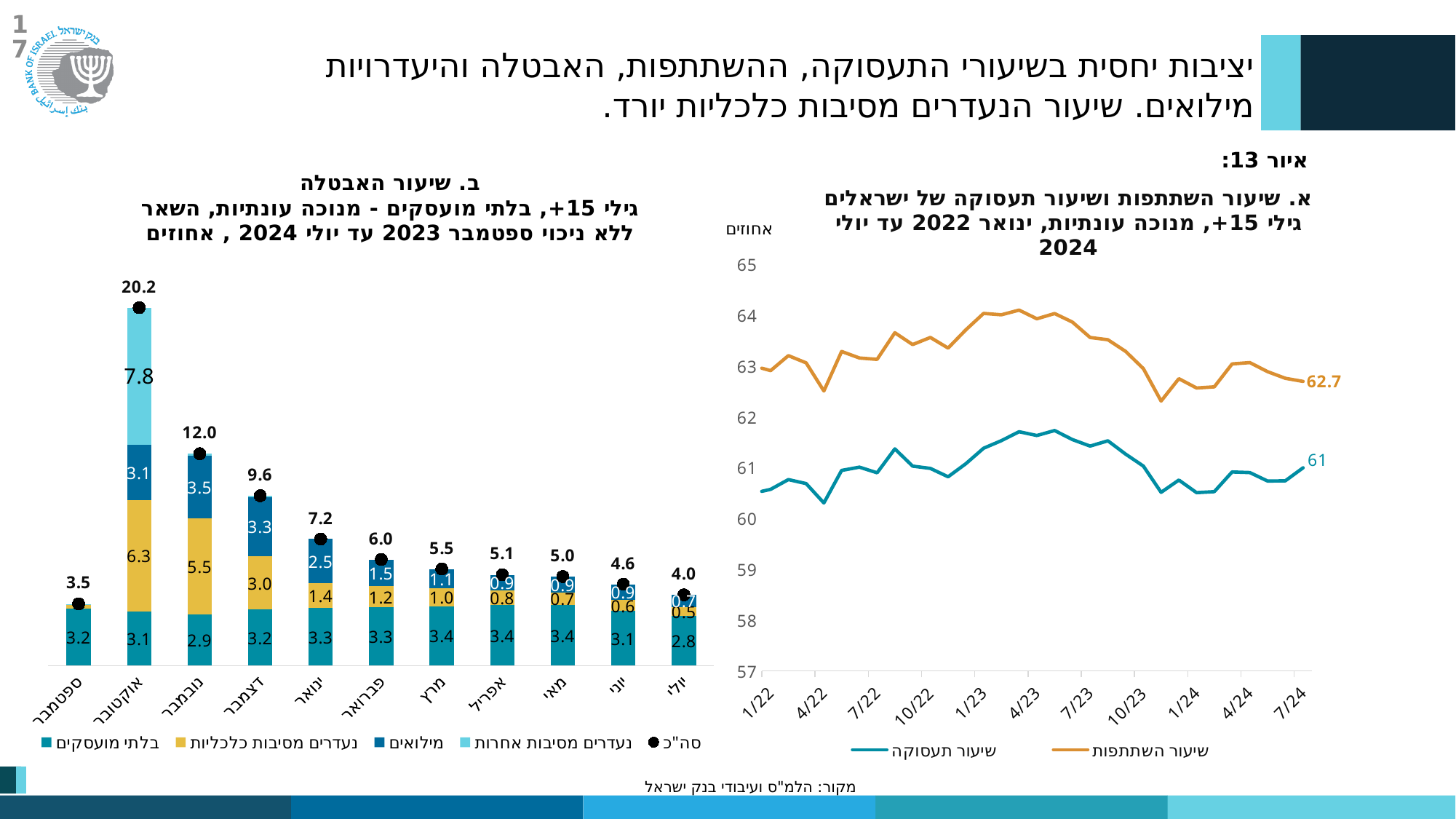
How many series does the legend of the right chart (א. שיעור השתתפות ושיעור תעסוקה) list? 2 In the right chart (א. שיעור השתתפות ושיעור תעסוקה), is the value of שיעור תעסוקה at 4/22 greater or less than 61? less In the left chart (ב. שיעור האבטלה), which month has the highest total? אוקטובר In the left chart (ב. שיעור האבטלה), what is the value of בלתי מועסקים for יולי? 2.8 What kind of chart is the left chart (ב. שיעור האבטלה)? bar chart In the left chart (ב. שיעור האבטלה), what is the value of נעדרים מסיבות אחרות for אוקטובר? 7.8 In the right chart (א. שיעור השתתפות ושיעור תעסוקה), what is the labelled value of שיעור השתתפות at the end of the series (7/24)? 62.7 What kind of chart is the right chart (א. שיעור השתתפות ושיעור תעסוקה)? line chart In the left chart (ב. שיעור האבטלה), what is the difference between the totals for אוקטובר and נובמבר? 8.2 In the left chart (ב. שיעור האבטלה), what is the total (סה"כ) for אוקטובר? 20.2 How many months are shown on the x axis of the left chart (ב. שיעור האבטלה)? 11 In the left chart (ב. שיעור האבטלה), which month has the lowest total? ספטמבר